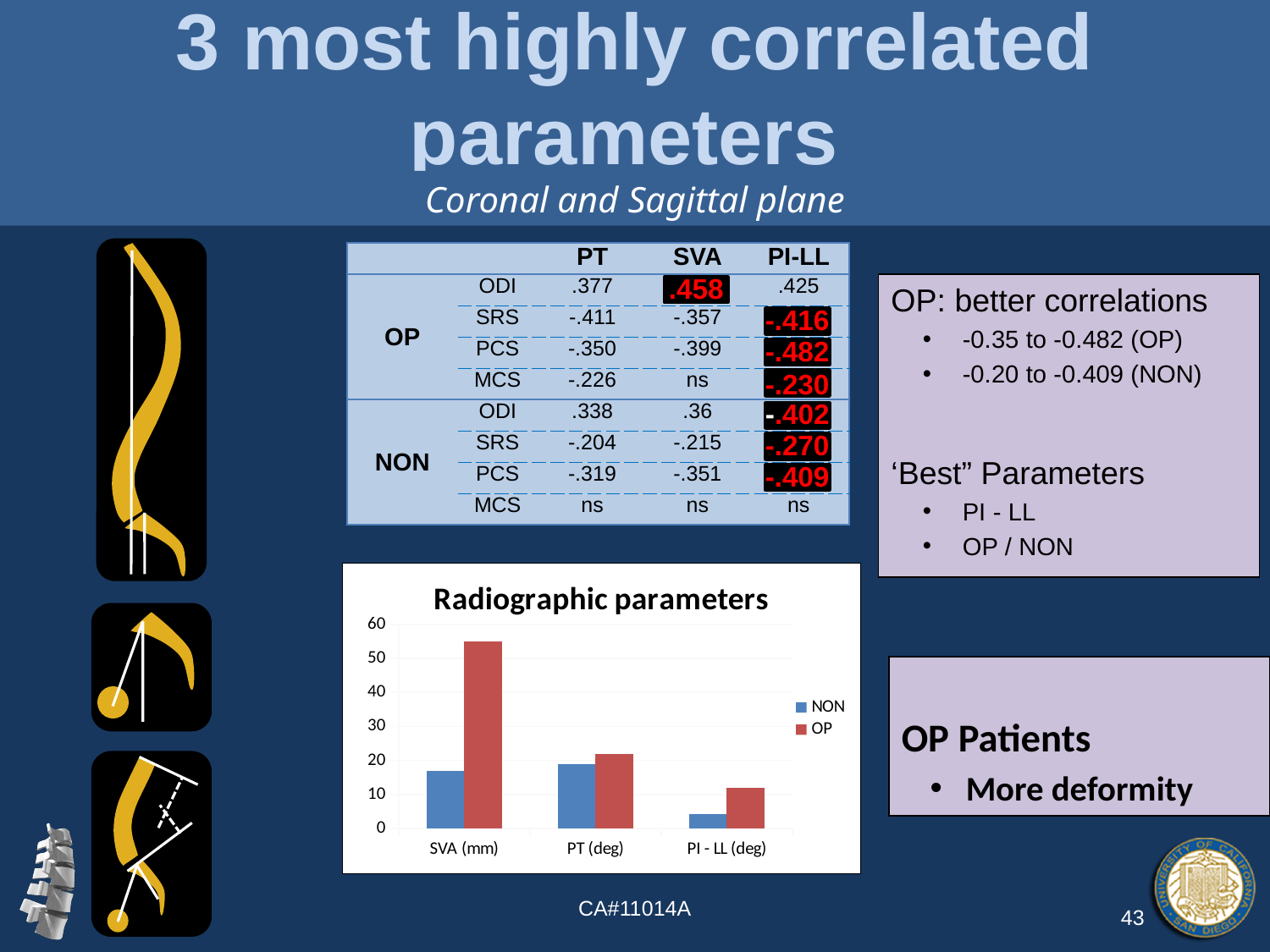
In the "Radiographic parameters" chart, which is larger for PI - LL (deg): the NON value or the OP value? OP In the "Radiographic parameters" chart, which category has the lowest NON value? PI - LL (deg) How many categories are shown on the x axis of the "Radiographic parameters" chart? 3 Which series is shown in red in the "Radiographic parameters" chart? OP In the "Radiographic parameters" chart, which is larger for SVA (mm): the NON value or the OP value? OP In the "Radiographic parameters" chart, is the NON value for PI - LL (deg) greater or less than 10? less How many series does the legend of the "Radiographic parameters" chart list? 2 In the "Radiographic parameters" chart, is the OP value for SVA (mm) greater or less than 50? greater In the "Radiographic parameters" chart, is the NON value for SVA (mm) greater or less than 20? less In the "Radiographic parameters" chart, which category has the tallest bar? SVA (mm) What kind of chart is the "Radiographic parameters" chart? bar chart What is the title of the chart on the slide? Radiographic parameters